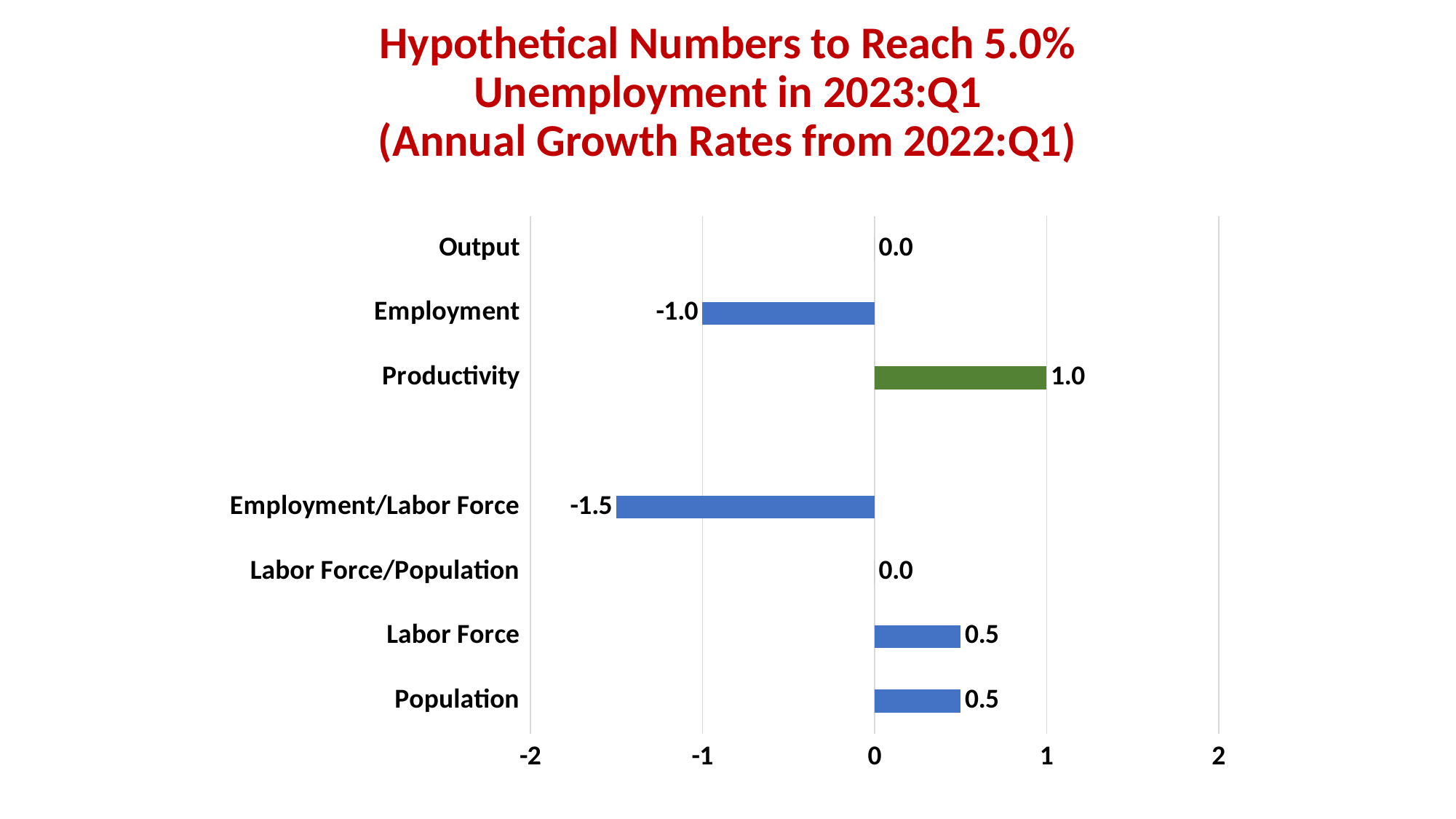
How many categories are shown on the chart? 7 What is the value for Employment/Labor Force? -1.5 What is the value for Labor Force? 0.5 Which is larger, the value for Labor Force or the value for Employment? Labor Force What is the difference between the values for Productivity and Employment? 2.0 Which category has the highest value? Productivity What is the value for Output? 0.0 What is the value for Productivity? 1.0 What kind of chart is shown on the slide? Bar chart What is the value for Employment? -1.0 Which category's bar is coloured green? Productivity Which category has the lowest value? Employment/Labor Force